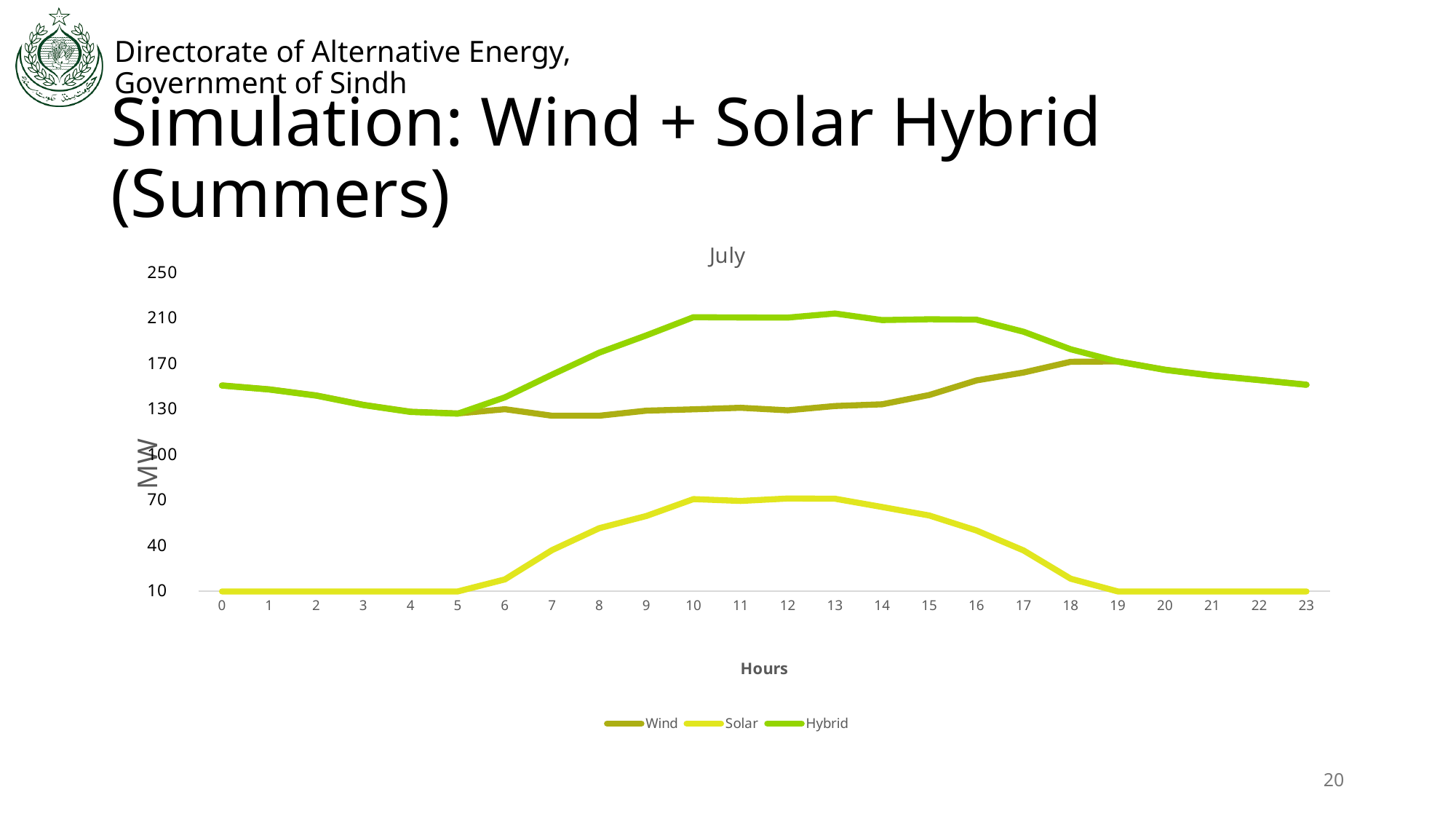
Which series has the lowest value at hour 12? Solar How many series does the legend list? 3 Is the value for Wind at hour 7 greater or less than 170? less Is the value for Solar at hour 12 greater or less than 40? greater What is the label on the y axis? MW Does the Solar line rise or fall between hour 5 and hour 10? rise Which series has the highest value at hour 12? Hybrid What is the title of the chart? July How many hourly points are plotted along the x axis? 24 Is the value for Hybrid at hour 10 greater or less than 170? greater Does the Hybrid line rise or fall between hour 13 and hour 23? fall What kind of chart is shown on the slide? line chart